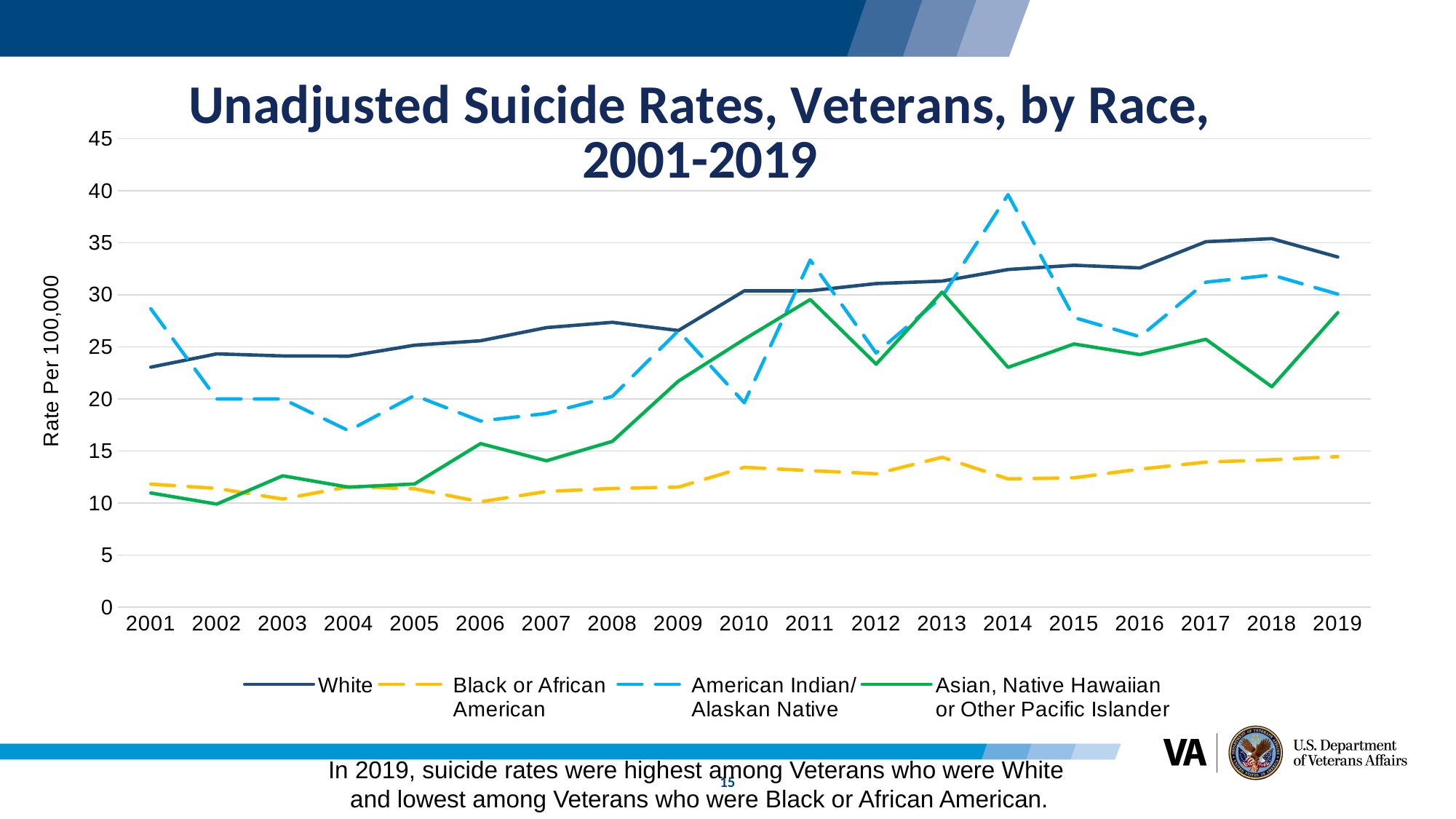
Does the White line generally rise or fall from 2001 to 2019? rise Is the value for Asian, Native Hawaiian or Other Pacific Islander in 2018 greater or less than 25? less In 2001, which is higher: the rate for American Indian/Alaskan Native or the rate for White? American Indian/Alaskan Native Is the value for White in 2019 greater or less than 30? greater Which race group has the highest suicide rate in 2019? White How many years are plotted along the x axis? 19 Which race group has the lowest suicide rate in 2019? Black or African American What kind of chart is shown on the slide? line chart How many series does the legend list? 4 In which year does the American Indian/Alaskan Native line reach its highest value? 2014 Is the value for Black or African American in 2001 greater or less than 15? less In 2014, which is higher: the rate for American Indian/Alaskan Native or the rate for White? American Indian/Alaskan Native